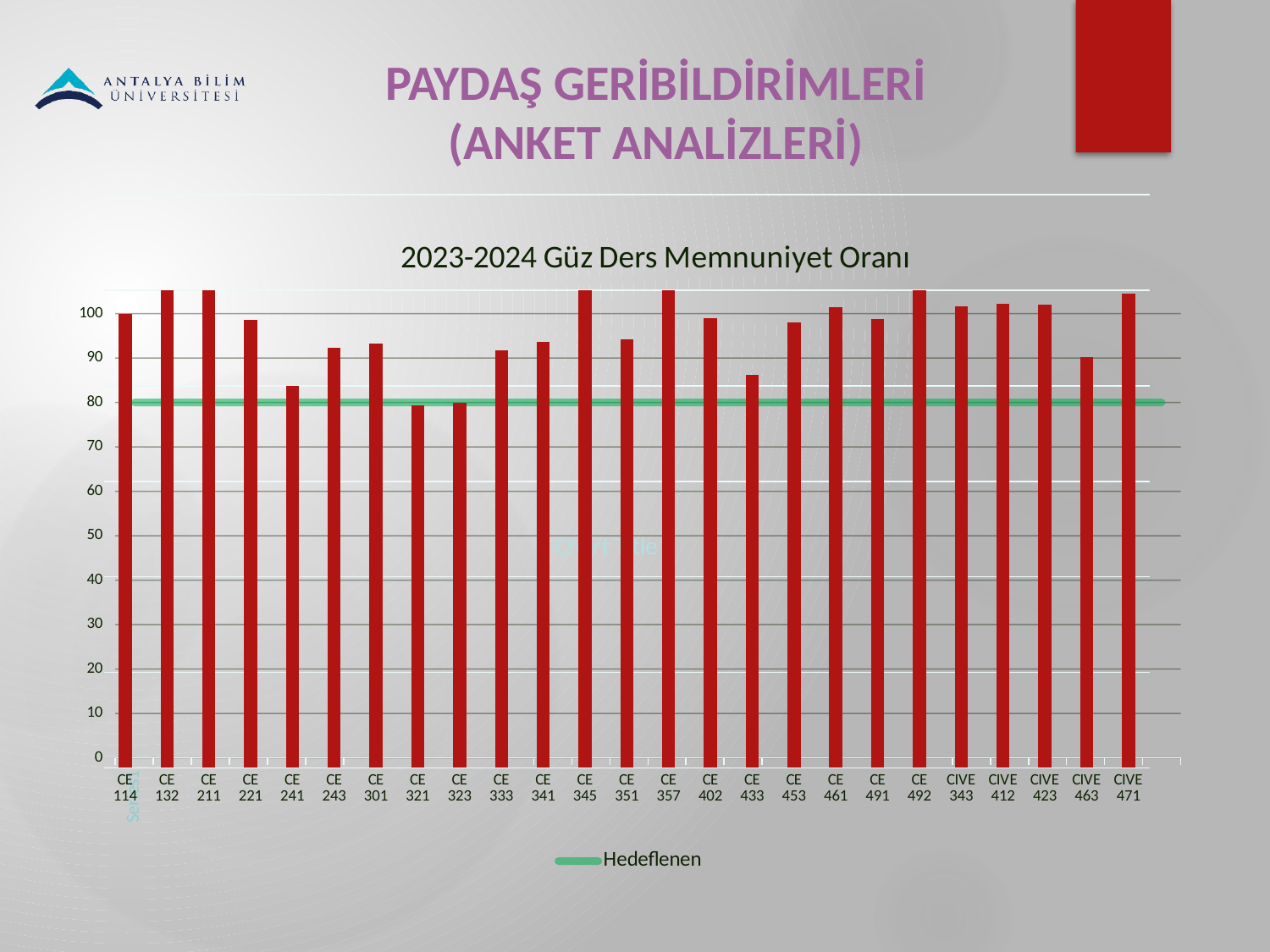
What is the title of the chart? 2023-2024 Güz Ders Memnuniyet Oranı Which has the larger value, CE 221 or CE 241? CE 221 What is the name of the series shown in the legend? Hedeflenen Is the value for CE 433 greater or less than 90? less How many series does the legend list? 1 How many course categories are shown on the x axis? 25 Is the value for CE 221 greater or less than 90? greater At what value does the green Hedeflenen line sit? 80 What kind of chart is shown on the slide? bar chart Which has the larger value, CE 321 or CE 345? CE 345